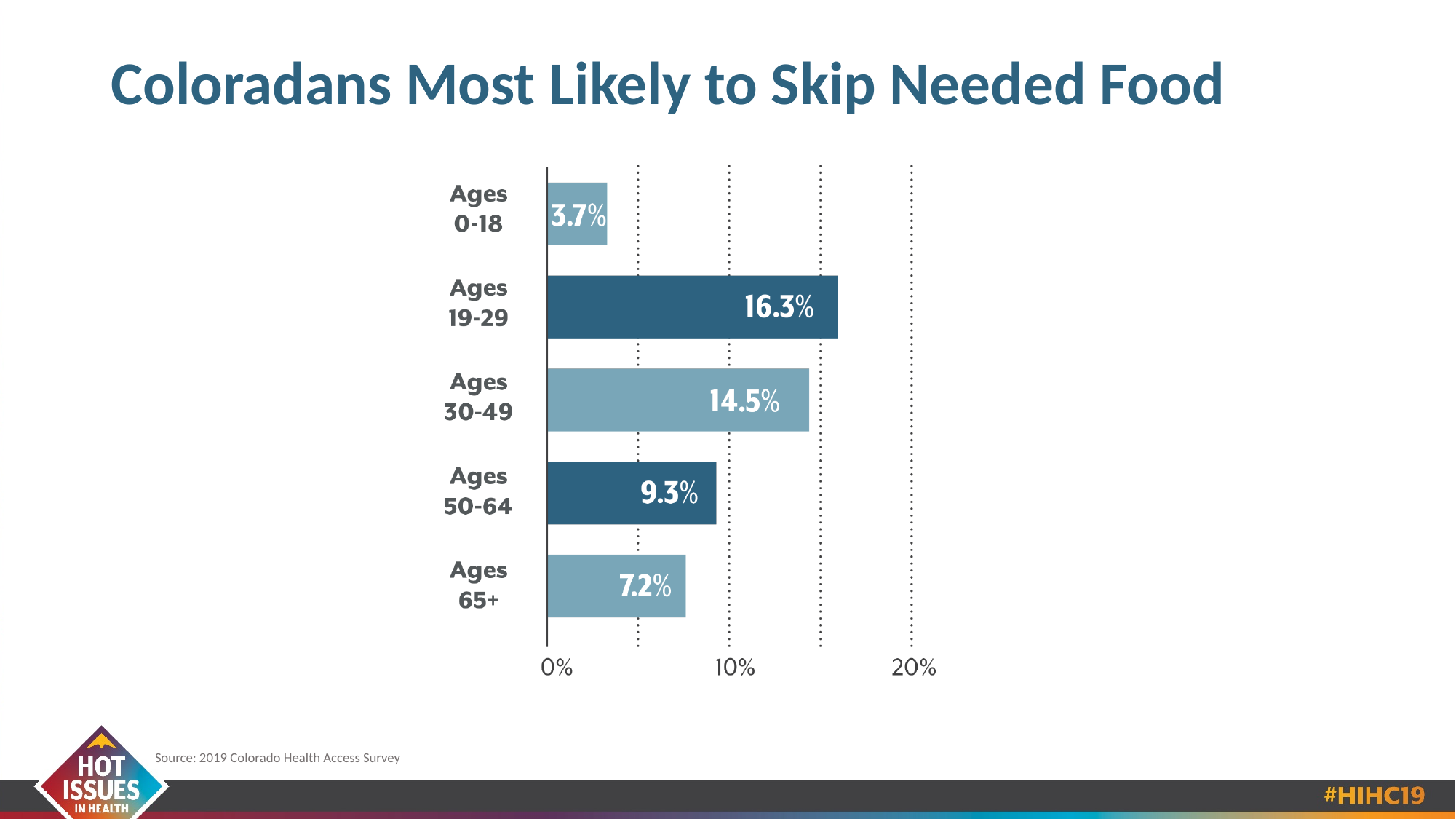
What is the difference in percentage points between Ages 50-64 and Ages 65+? 2.1 What percentage of Coloradans ages 19-29 skipped needed food? 16.3% How many age groups are shown in the chart? 5 What is the difference in percentage points between Ages 19-29 and Ages 30-49? 1.8 What is the title of the chart on the slide? Coloradans Most Likely to Skip Needed Food What is the value shown for Ages 65+? 7.2% Is the value for Ages 50-64 greater or less than 10%? less Which age group has the lowest percentage of skipping needed food? Ages 0-18 Which age group has the highest percentage of skipping needed food? Ages 19-29 Which is larger, the value for Ages 30-49 or the value for Ages 50-64? Ages 30-49 What kind of chart is shown on the slide? Bar chart What is the value shown for Ages 0-18? 3.7%